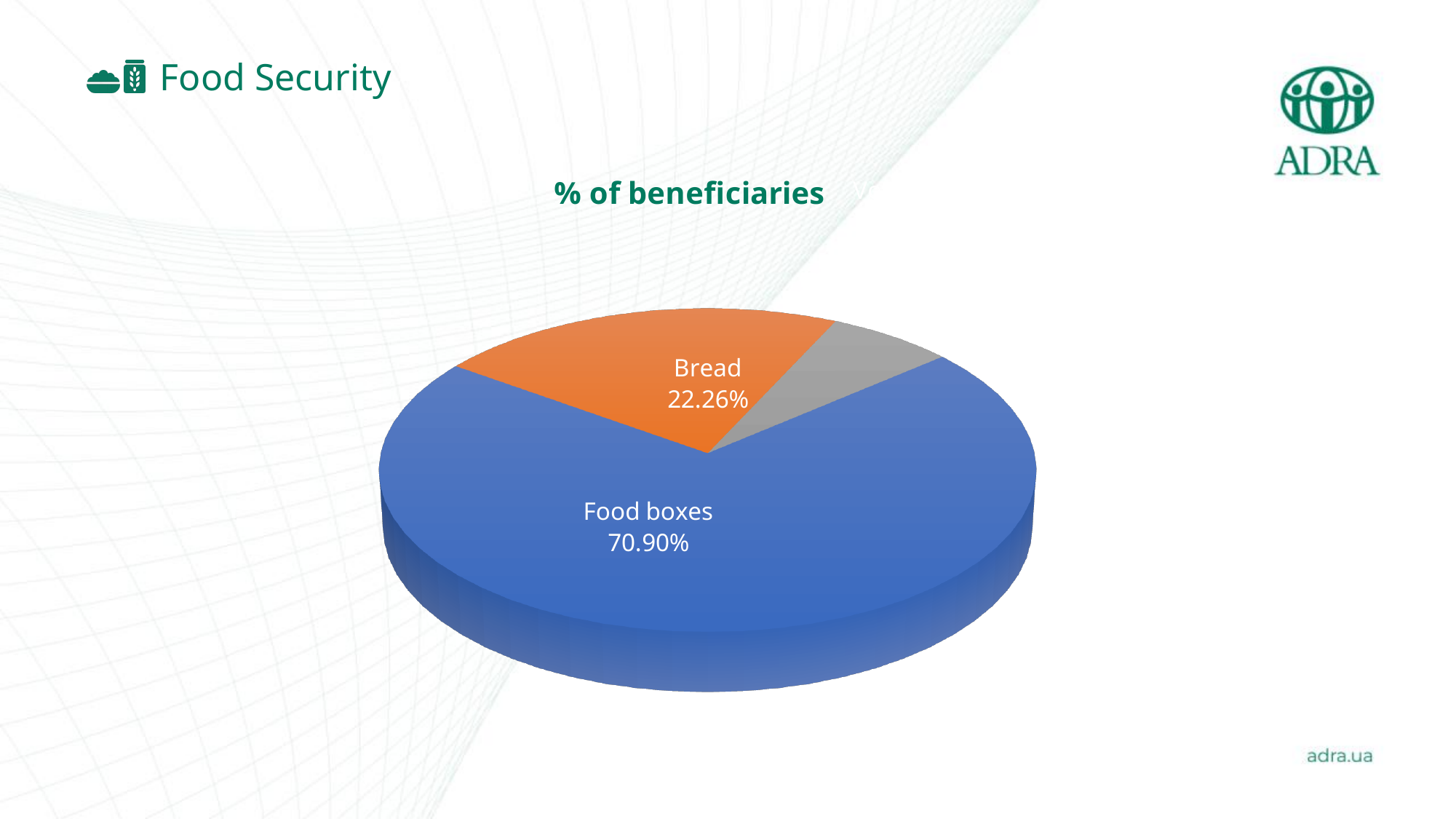
What percentage of beneficiaries does the Food boxes slice represent? 70.90% What is the difference in percentage points between the Food boxes slice and the Bread slice? 48.64 Which is larger, the Food boxes slice or the Bread slice? Food boxes What percentage of beneficiaries does the Bread slice represent? 22.26% What colour is the Food boxes slice? blue Is the share for Food boxes greater or less than 50%? greater What is the title of the pie chart? % of beneficiaries Is the share for Bread greater or less than 25%? less How many slices does the pie chart have? 3 What kind of chart is shown on the slide? pie chart Which slice of the pie chart is the largest? Food boxes